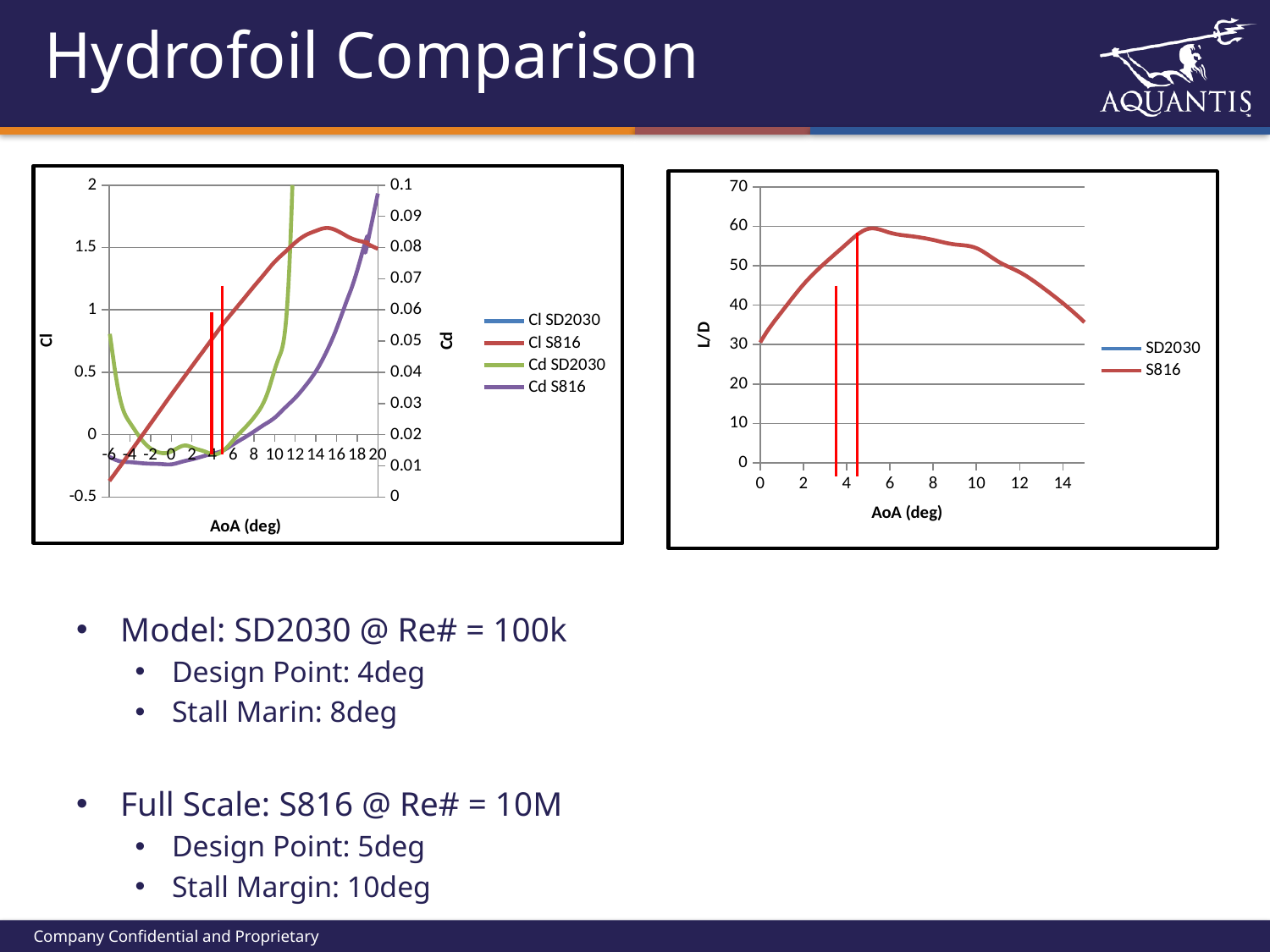
In the right chart, is the L/D value for S816 at AoA 10 deg greater or less than 50? greater In the right chart, does the S816 L/D curve rise or fall as AoA increases from 10 to 14 deg? fall In the right chart, is the L/D value for S816 at AoA 2 deg greater or less than 40? greater In the left chart, is the Cd S816 value at AoA 10 deg greater or less than 0.02? greater How many series does the legend of the right chart list? 2 What is the label of the x axis on the right chart? AoA (deg) How many series does the legend of the left chart list? 4 In the right chart, does the S816 L/D curve rise or fall as AoA increases from 0 to 4 deg? rise What kind of chart is the chart on the right of the slide? line chart